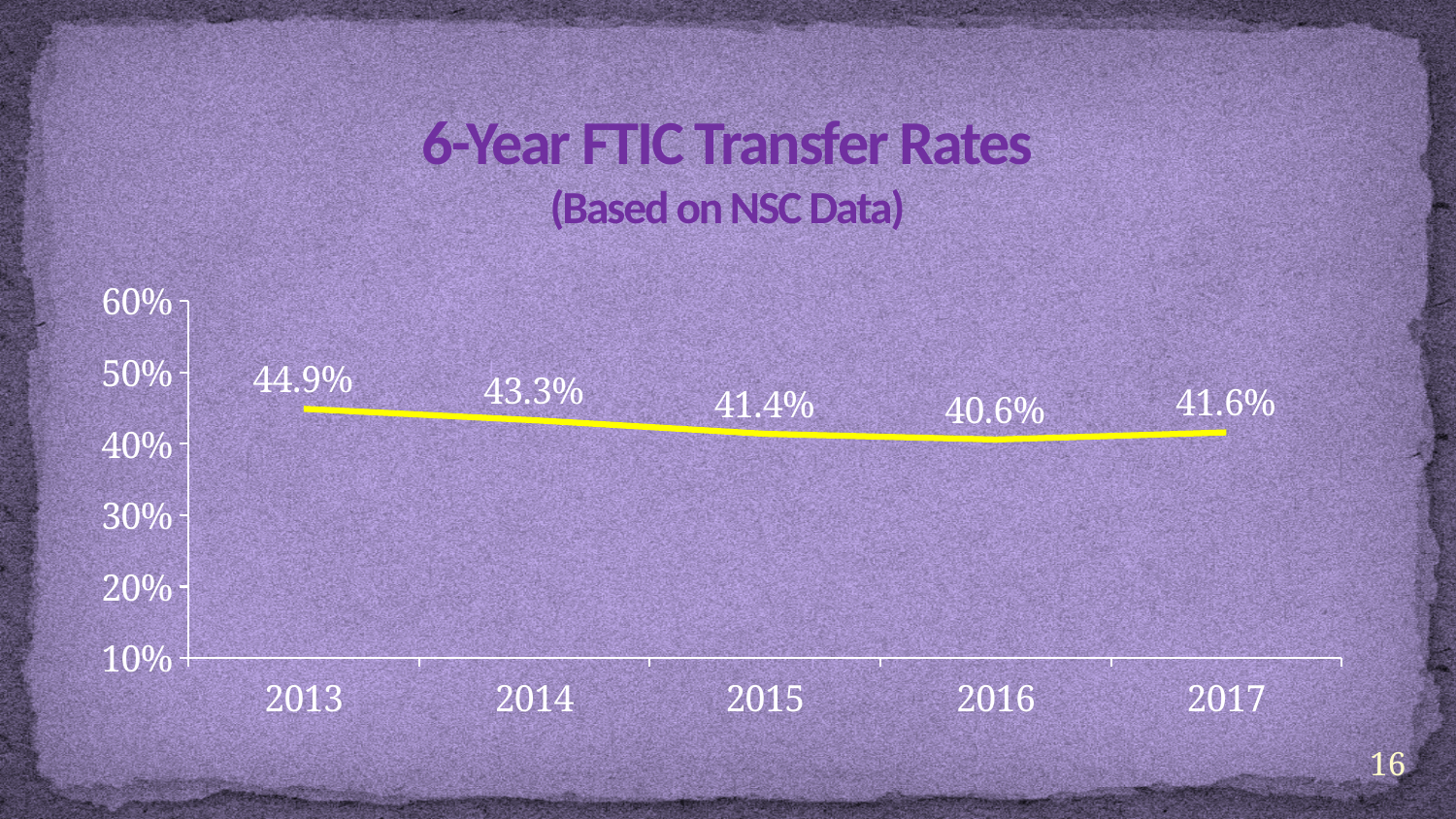
How many years are plotted on the chart? 5 What is the 6-year FTIC transfer rate for 2016? 40.6% Is the transfer rate for 2015 greater or less than 50%? less Which year has a higher transfer rate, 2014 or 2015? 2014 What is the 6-year FTIC transfer rate for 2013? 44.9% Which year has the highest 6-year FTIC transfer rate? 2013 What is the 6-year FTIC transfer rate for 2017? 41.6% Which year has the lowest 6-year FTIC transfer rate? 2016 What is the title of the chart? 6-Year FTIC Transfer Rates (Based on NSC Data) What is the difference in percentage points between the 2013 and 2017 transfer rates? 3.3 What kind of chart is shown on the slide? line chart Does the transfer rate rise or fall from 2013 to 2016? fall